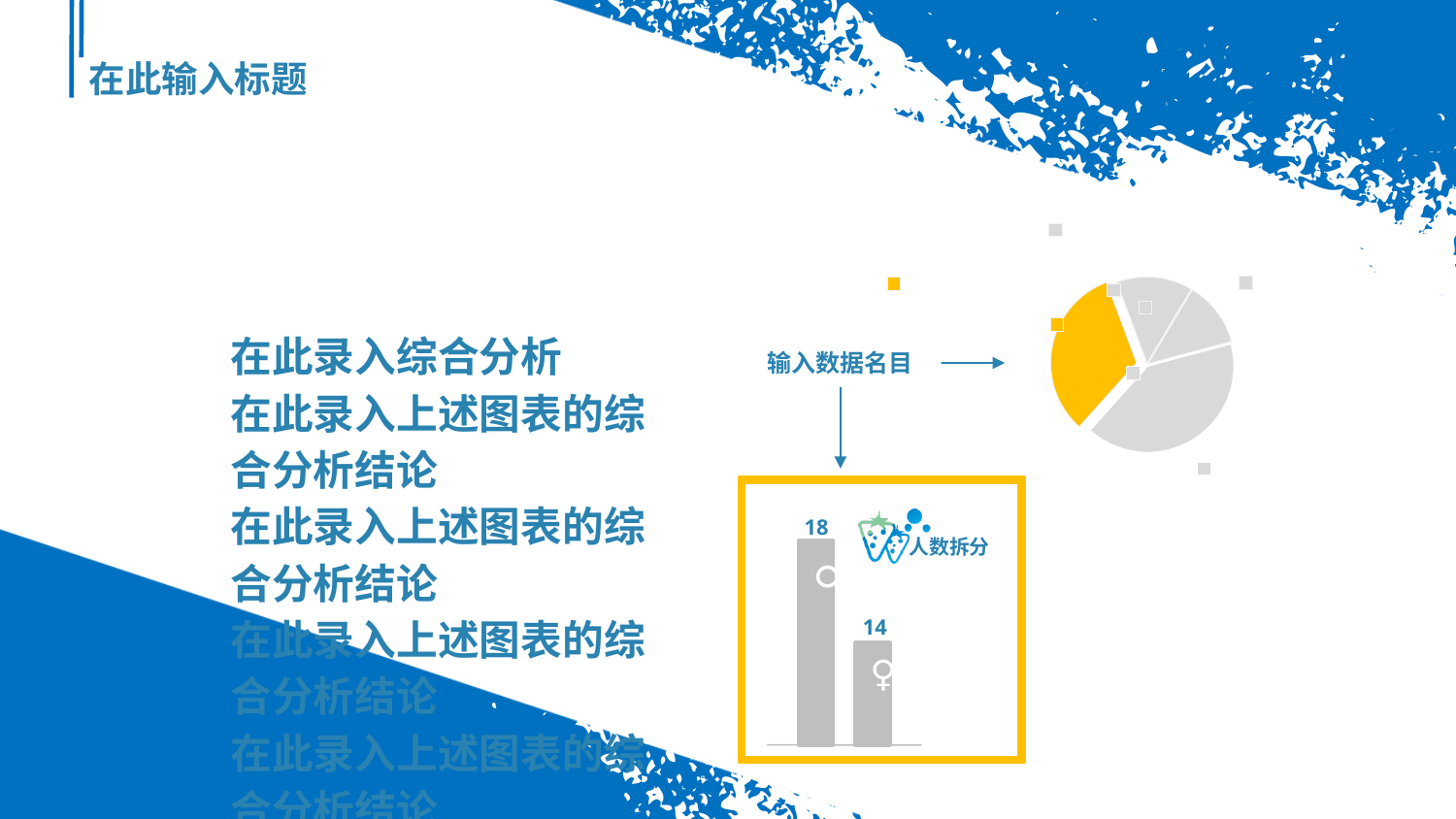
What kind of chart is shown at the top right of the slide? Pie chart In the bar chart titled 人数拆分, which bar is the tallest? The male bar (18) In the bar chart titled 人数拆分, what is the value of the bar with the female symbol? 14 How many bars are shown in the bar chart titled 人数拆分? 2 In the bar chart titled 人数拆分, which bar is the shortest? The female bar (14) In the bar chart titled 人数拆分, what is the difference between the male bar and the female bar? 4 In the pie chart at the top right, what colour is the highlighted slice? Yellow What kind of chart is the chart inside the yellow frame at the bottom of the slide? Bar chart What is the title of the bar chart inside the yellow frame? 人数拆分 In the bar chart titled 人数拆分, what is the value of the bar with the male symbol? 18 In the bar chart titled 人数拆分, is the male bar or the female bar larger? The male bar